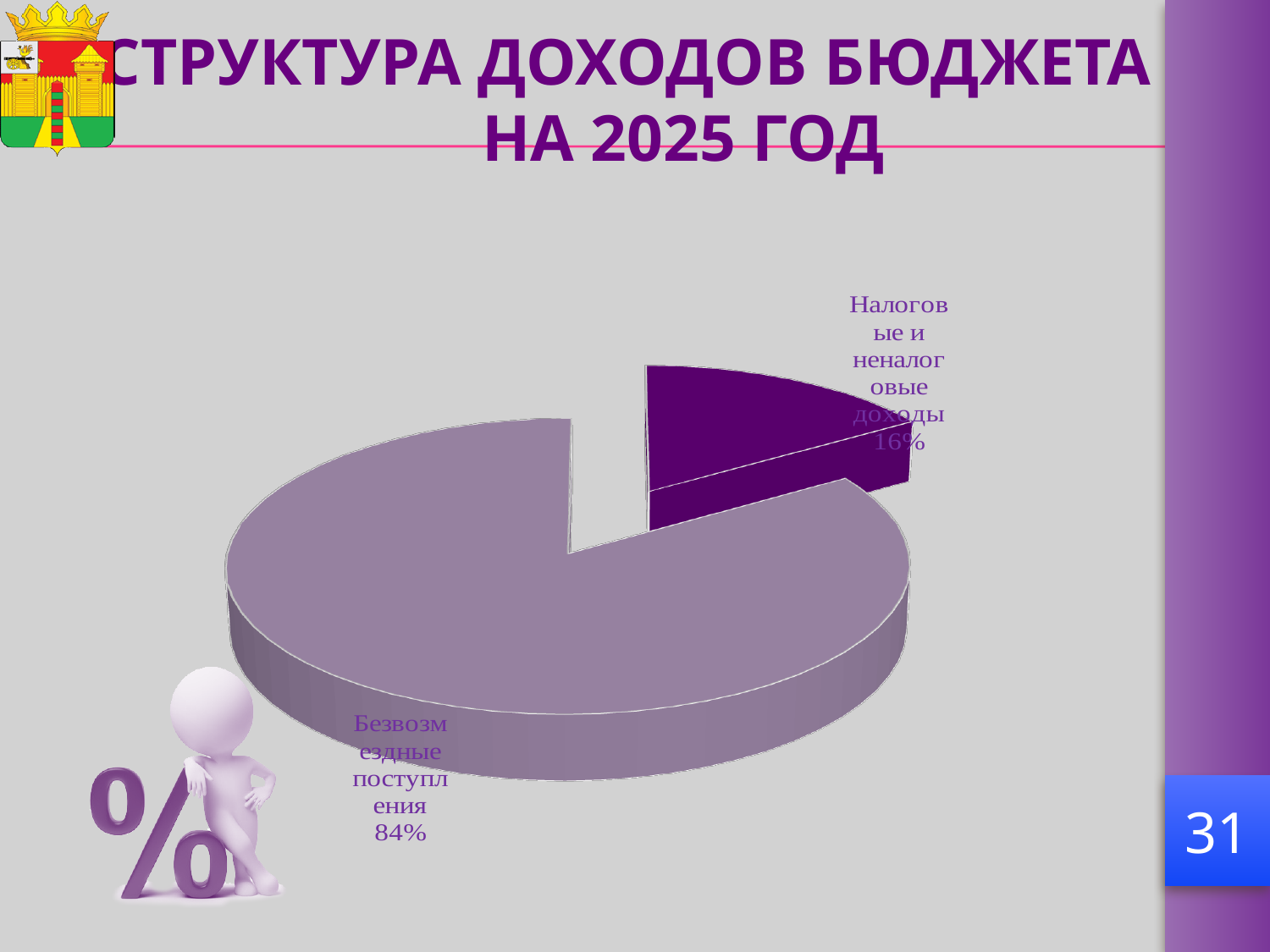
What is the difference in percentage points between "Безвозмездные поступления" and "Налоговые и неналоговые доходы"? 68 Which category has the smallest slice of the pie? Налоговые и неналоговые доходы How many slices does the pie chart have? 2 What share of the pie does "Безвозмездные поступления" represent? 84% Which slice is drawn in dark purple and pulled out from the pie? Налоговые и неналоговые доходы What is the title of the slide containing the chart? СТРУКТУРА ДОХОДОВ БЮДЖЕТА НА 2025 ГОД What kind of chart is shown on the slide? Pie chart What share of the pie does "Налоговые и неналоговые доходы" represent? 16% Which is larger: the share of "Безвозмездные поступления" or the share of "Налоговые и неналоговые доходы"? Безвозмездные поступления Which category has the largest slice of the pie? Безвозмездные поступления What is the total of the two slice percentages shown? 100%